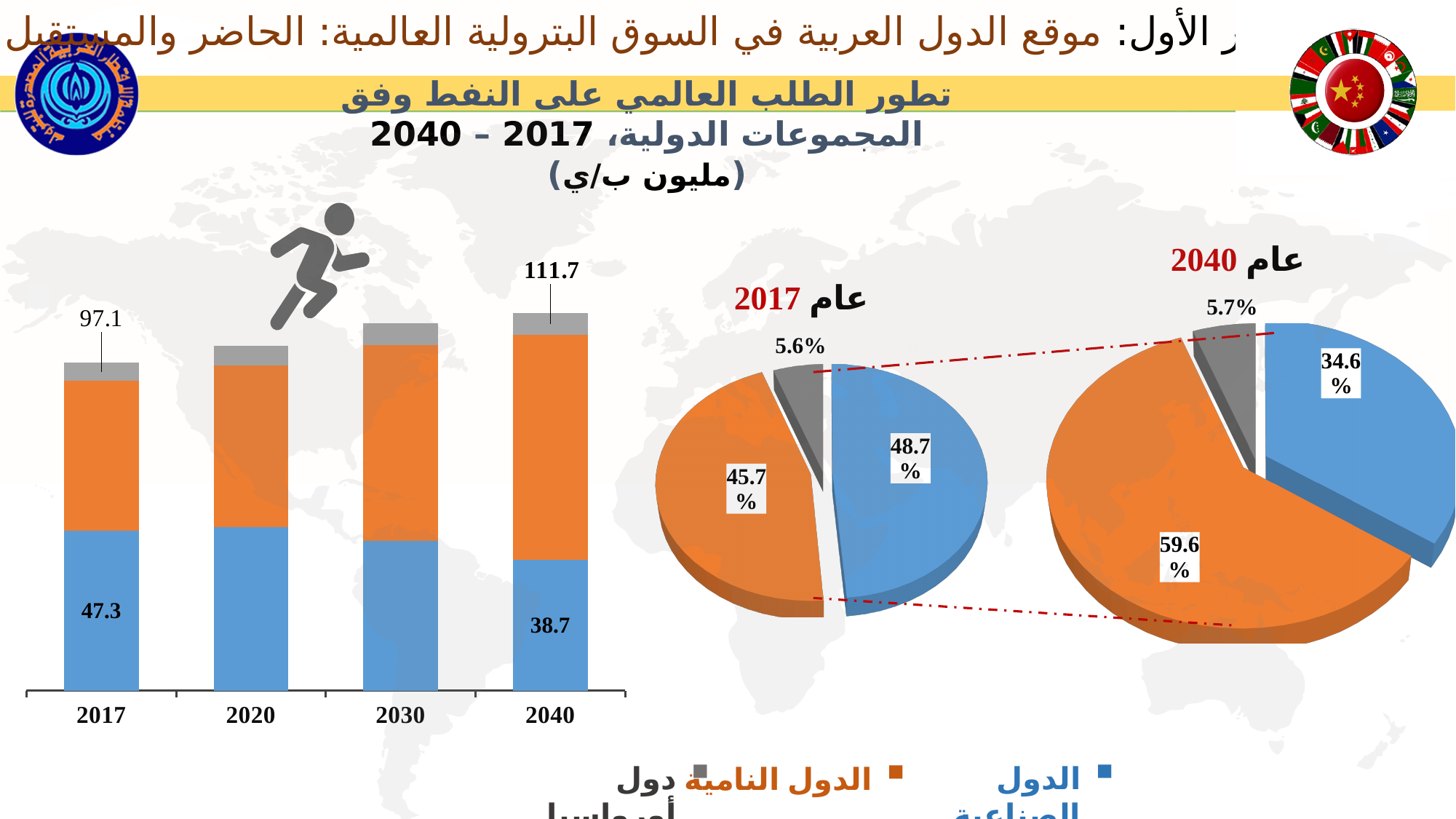
In the stacked bar chart on the left, what is the difference between the 2040 total and the 2017 total? 14.6 In the 2017 pie chart, what share is shown for the blue (industrial countries) slice? 48.7% In the stacked bar chart on the left, what is the value of the blue (industrial countries) segment for 2040? 38.7 In the stacked bar chart on the left, how many years are shown on the x axis? 4 In the stacked bar chart on the left, what is the total value labelled above the 2040 bar? 111.7 In the stacked bar chart on the left, what is the total value labelled above the 2017 bar? 97.1 In the 2040 pie chart, what share is shown for the orange (developing countries) slice? 59.6% How many series does the legend at the bottom of the slide list? 3 In the stacked bar chart on the left, what is the value of the blue (industrial countries) segment for 2017? 47.3 In the 2017 pie chart, what share is shown for the grey (Eurasia) slice? 5.6% In the stacked bar chart on the left, do the total bar heights rise or fall from 2017 to 2040? rise In the 2040 pie chart, which slice is the largest? الدول النامية (developing countries, orange)